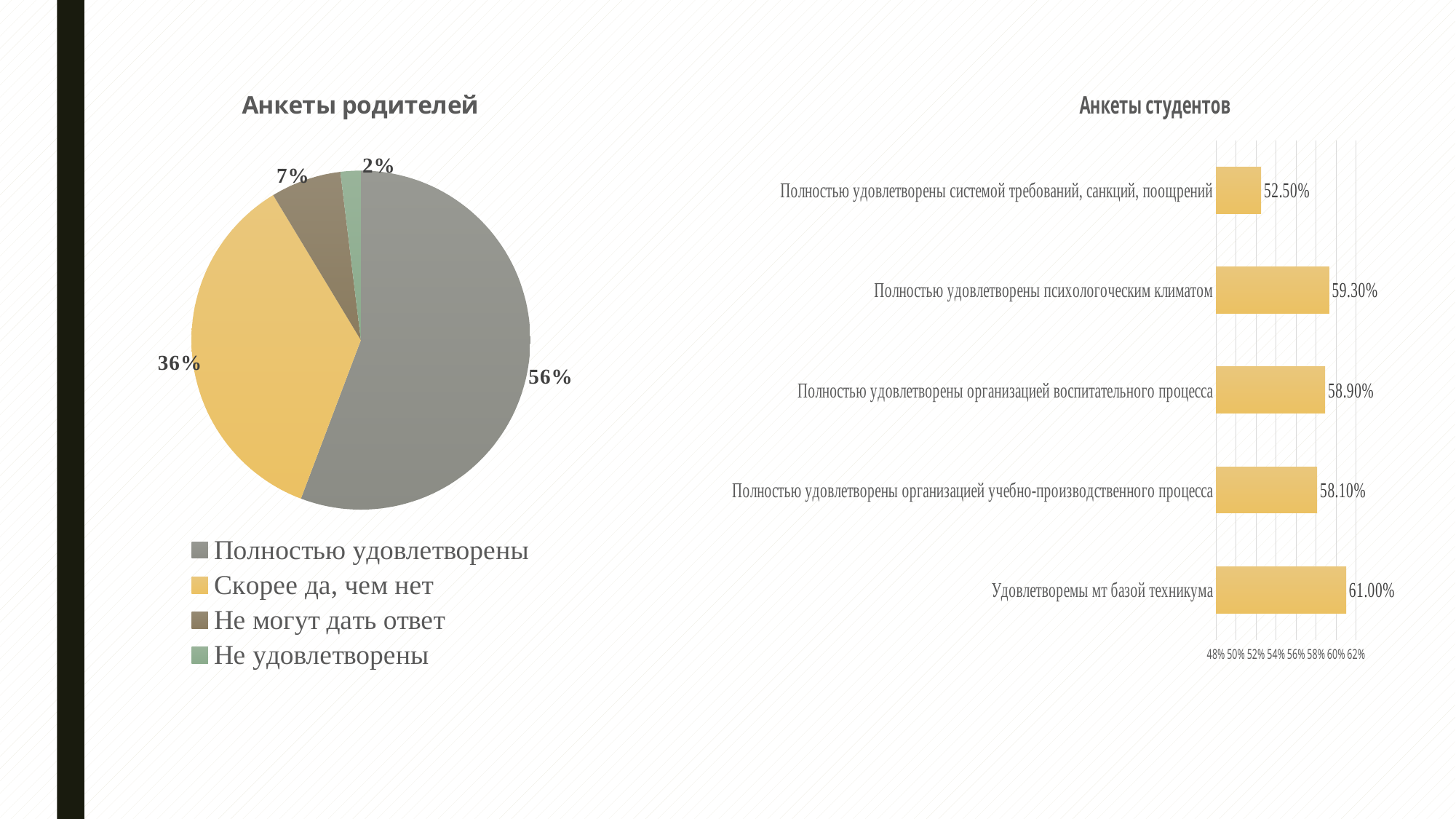
In the 'Анкеты родителей' chart, which category has the smallest slice? Не удовлетворены In the 'Анкеты студентов' chart, what is the value for 'Полностью удовлетворены психологоческим климатом'? 59.30% In the 'Анкеты студентов' chart, which category has the highest value? Удовлетворемы мт базой техникума What kind of chart is 'Анкеты студентов'? Bar chart How many categories does the legend of the 'Анкеты родителей' chart list? 4 In the 'Анкеты родителей' chart, what is the difference between the 'Полностью удовлетворены' and 'Скорее да, чем нет' slices? 20% In the 'Анкеты студентов' chart, what is the difference between 'Удовлетворемы мт базой техникума' and 'Полностью удовлетворены организацией учебно-производственного процесса'? 2.90% In the 'Анкеты родителей' chart, what share is labelled for 'Полностью удовлетворены'? 56% What kind of chart is 'Анкеты родителей'? Pie chart In the 'Анкеты родителей' chart, what share is labelled for 'Скорее да, чем нет'? 36% In the 'Анкеты студентов' chart, which category has the lowest value? Полностью удовлетворены системой требований, санкций, поощрений In the 'Анкеты студентов' chart, what is the value for 'Полностью удовлетворены системой требований, санкций, поощрений'? 52.50%